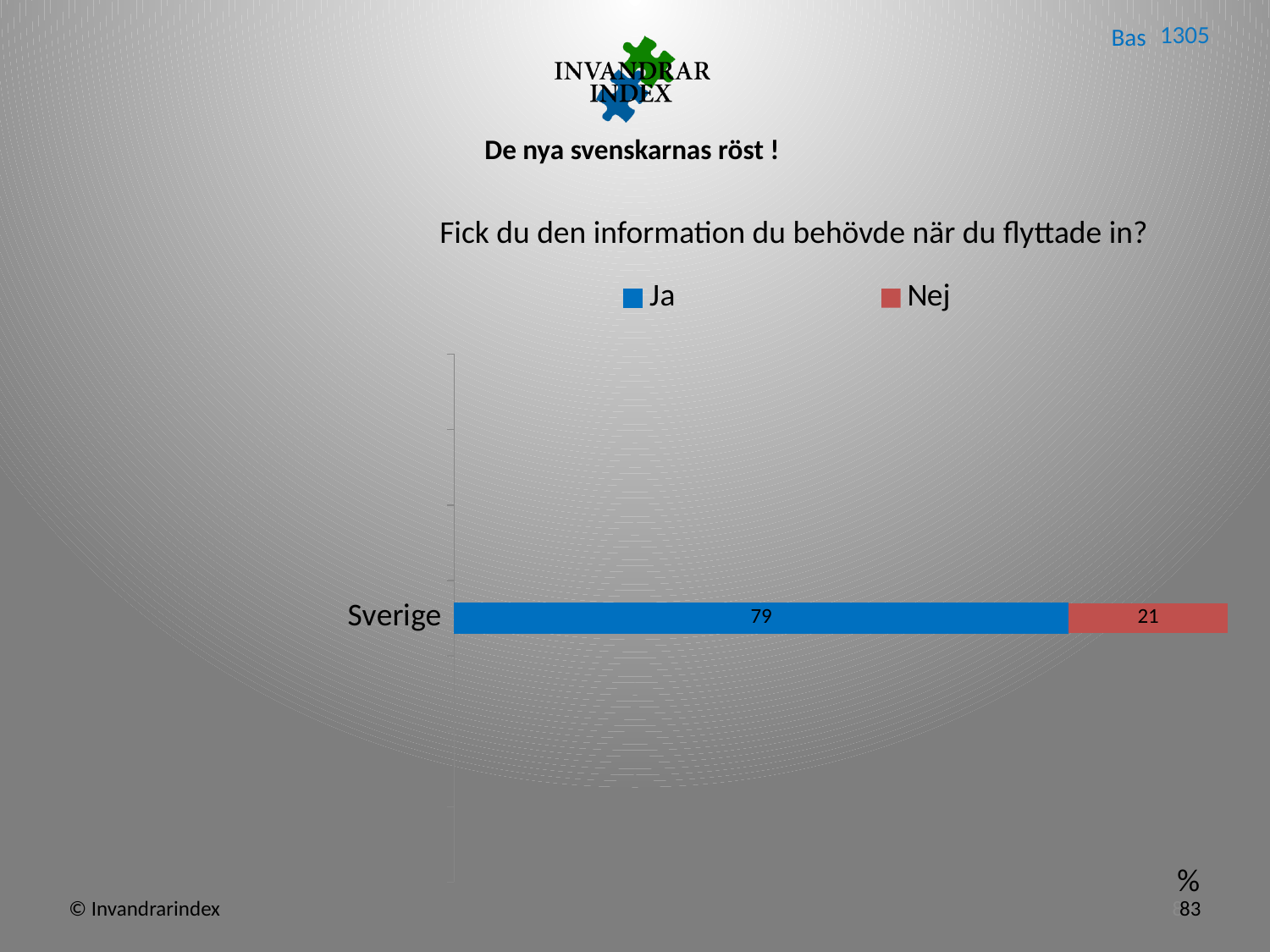
What is the total of the stacked bar for Sverige? 100 How many categories are shown on the chart? 1 What is the difference between the Ja and Nej values for Sverige? 58 How many series does the legend list? 2 What is the value for Nej for Sverige? 21 What is the label of the only category on the chart? Sverige What is the value for Ja for Sverige? 79 What kind of chart is shown? Stacked bar chart What is the title of the chart? Fick du den information du behövde när du flyttade in? Which series has the larger value for Sverige, Ja or Nej? Ja Which series is shown in blue? Ja